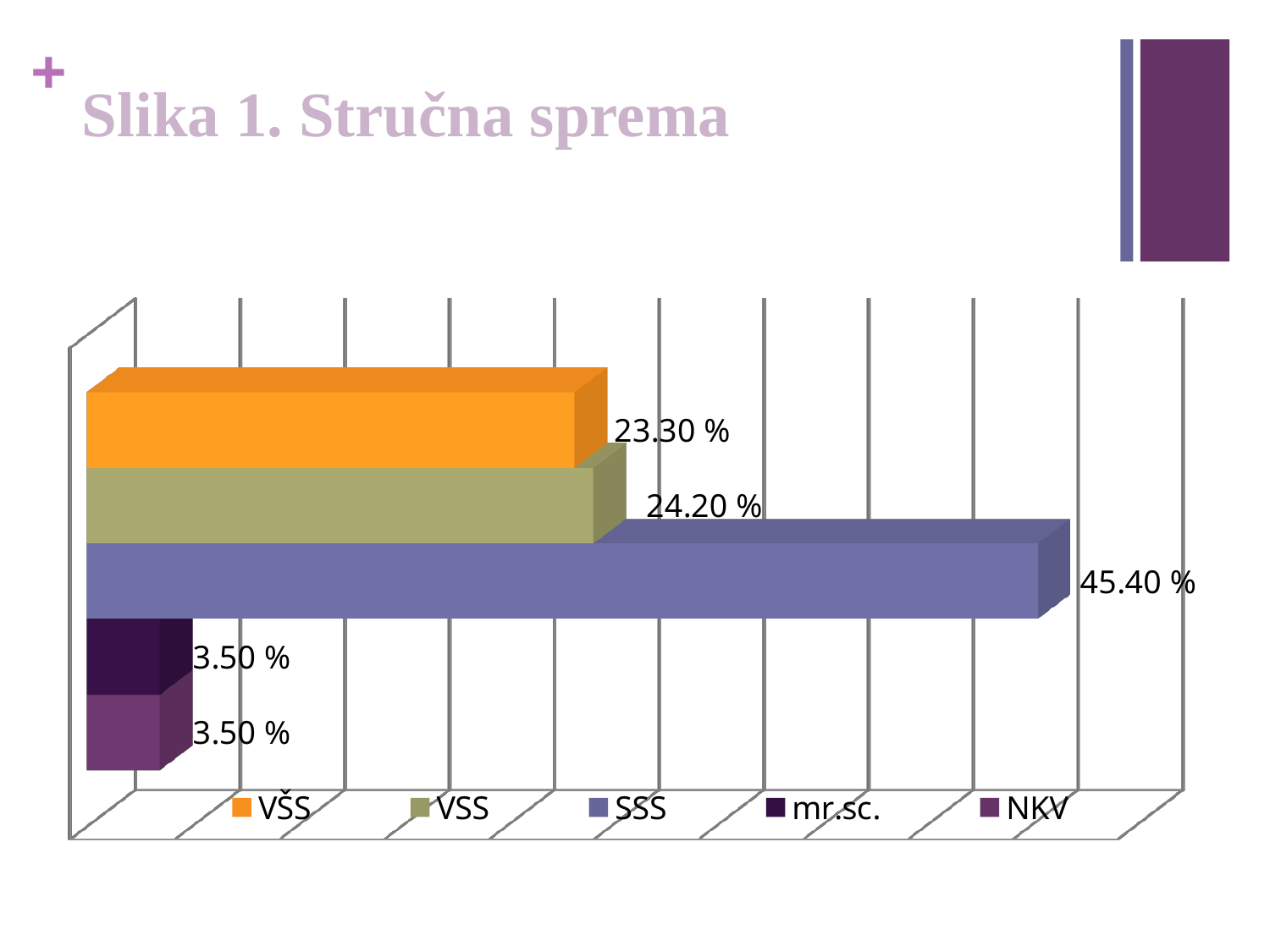
What is the value for VŠS? 23.30 % What is the value for VSS? 24.20 % What is the value for mr.sc.? 3.50 % Which category has the highest value? SSS What is the value for SSS? 45.40 % How many bars are plotted in the chart? 5 What is the difference between the values for VSS and VŠS? 0.90 % What is the value for NKV? 3.50 % What is the title of the slide? Slika 1. Stručna sprema What kind of chart is shown on the slide? bar chart Which is larger, the value for SSS or the value for VŠS? SSS What is the difference between the values for SSS and VSS? 21.20 %